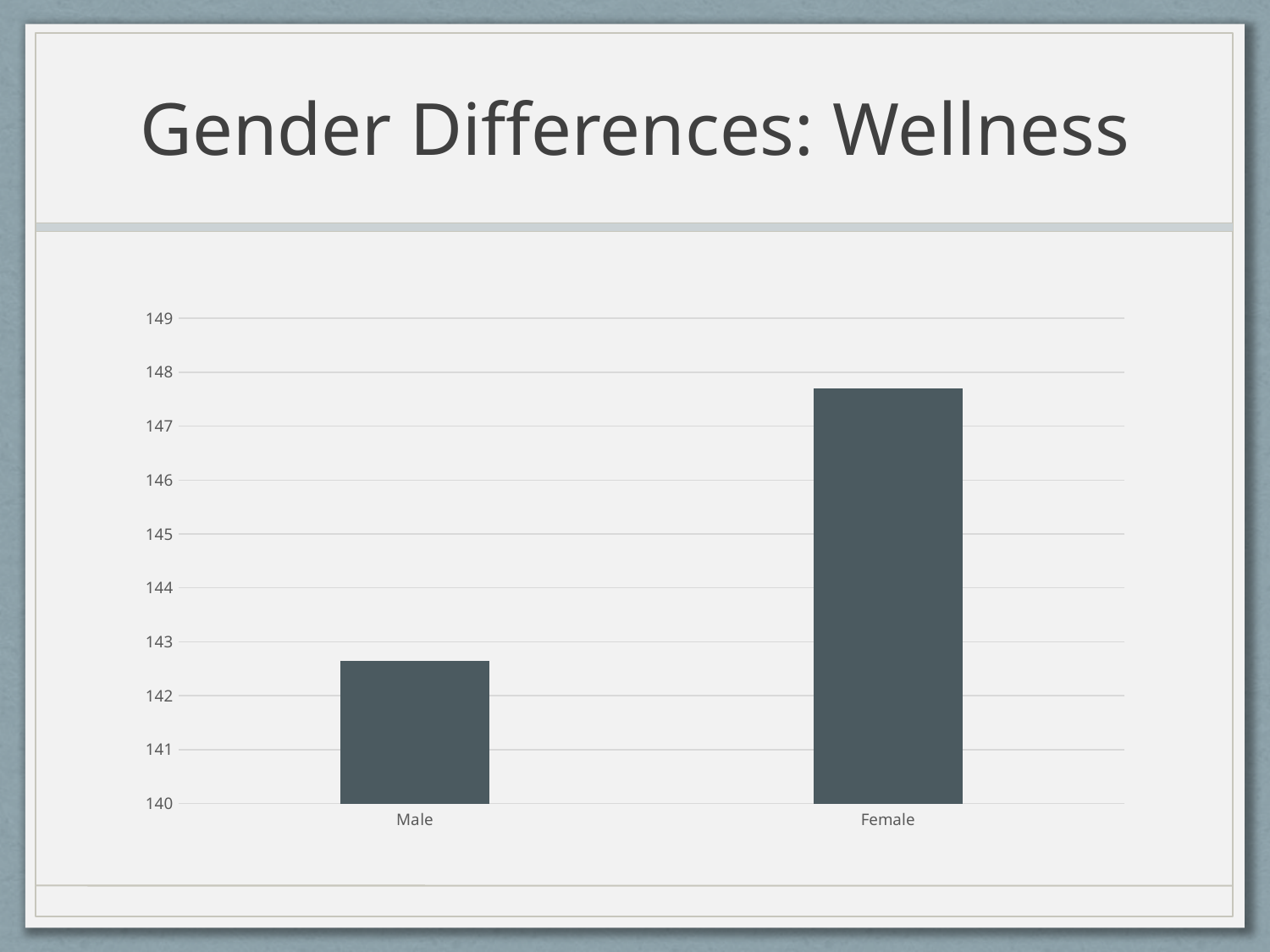
What kind of chart is shown on the slide? bar chart Is the value for Male greater or less than 142? greater How many categories are shown on the x axis? 2 Which is larger, the value for Male or the value for Female? Female Which category has the lowest value? Male What is the lowest value shown on the y axis? 140 Is the value for Male greater or less than 143? less What is the title of the slide containing the chart? Gender Differences: Wellness Is the value for Female greater or less than 147? greater Do the values rise or fall from Male to Female? rise Which category has the highest value? Female